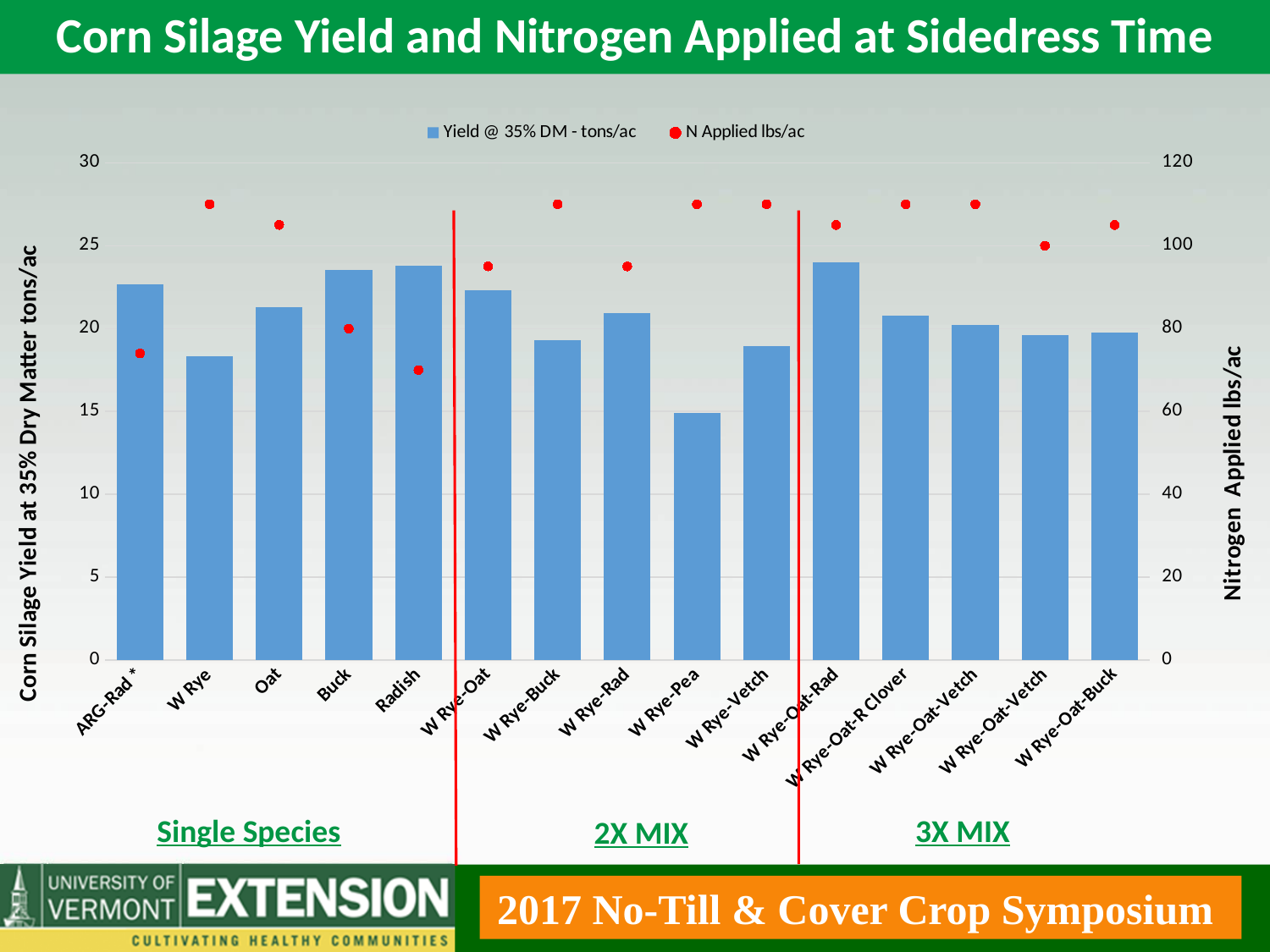
What are the three group labels shown below the x axis? Single Species, 2X MIX, 3X MIX Which has the higher N Applied value, Buck or Oat? Oat Is the yield for Oat greater or less than 20 tons/ac? greater Is the N Applied value for ARG-Rad * greater or less than 80 lbs/ac? less Which has the higher yield, W Rye-Pea or W Rye-Vetch? W Rye-Vetch Which has the higher yield, Buck or W Rye? Buck How many categories are shown on the x axis? 15 How many series does the legend list? 2 Is the yield for W Rye greater or less than 20 tons/ac? less Which category has the lowest corn silage yield? W Rye-Pea Which category has the lowest N Applied value? Radish